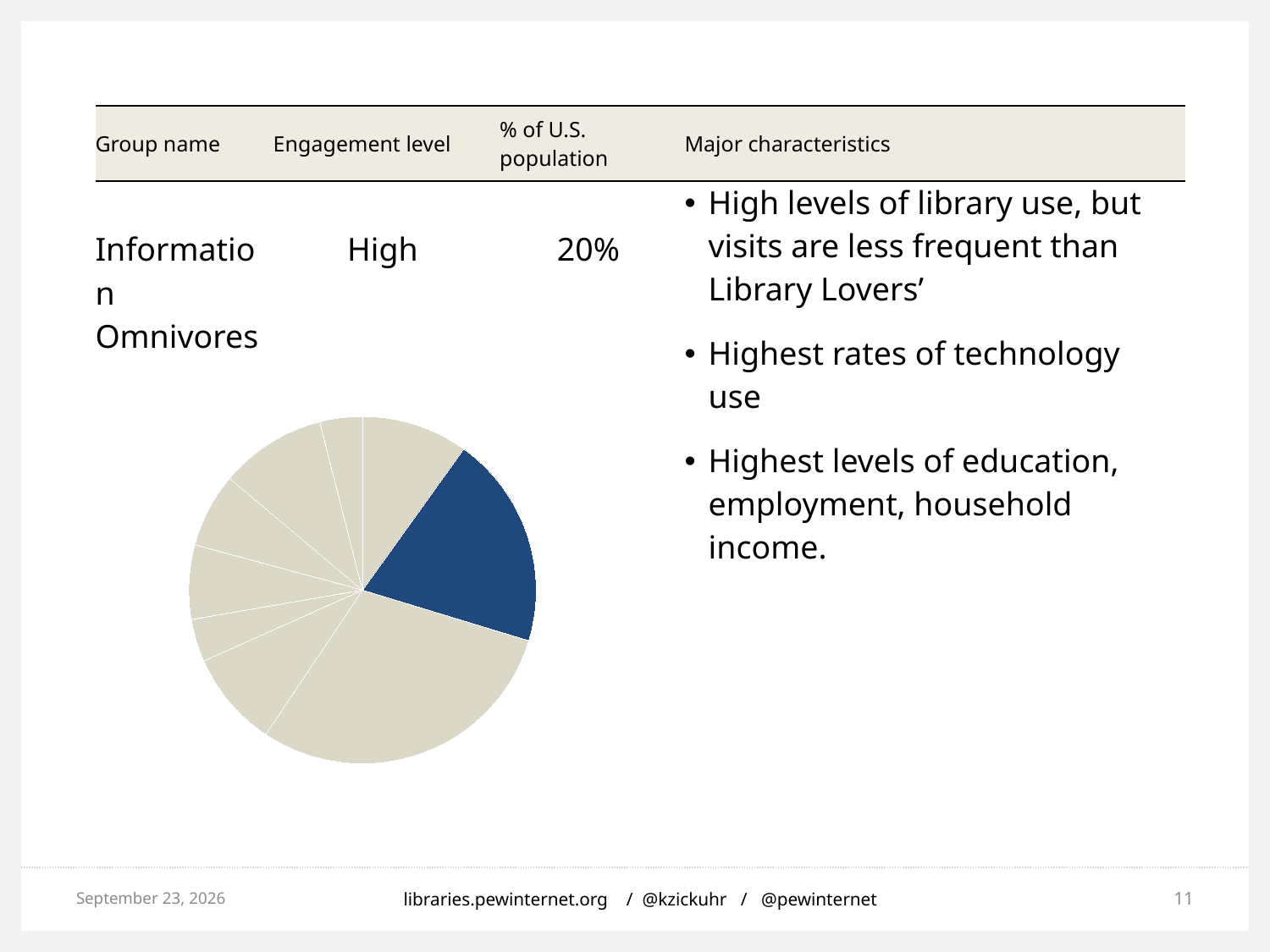
What colour is the highlighted slice of the pie chart? blue Which group does the highlighted slice of the pie chart represent? Information Omnivores What kind of chart is shown on the slide? pie chart What share of the pie does the highlighted (blue) slice, representing Information Omnivores, account for? 20% Is the highlighted blue slice of the pie greater or less than half of the pie? less Which is larger: the highlighted blue slice or the large beige slice at the bottom right of the pie? the large beige slice